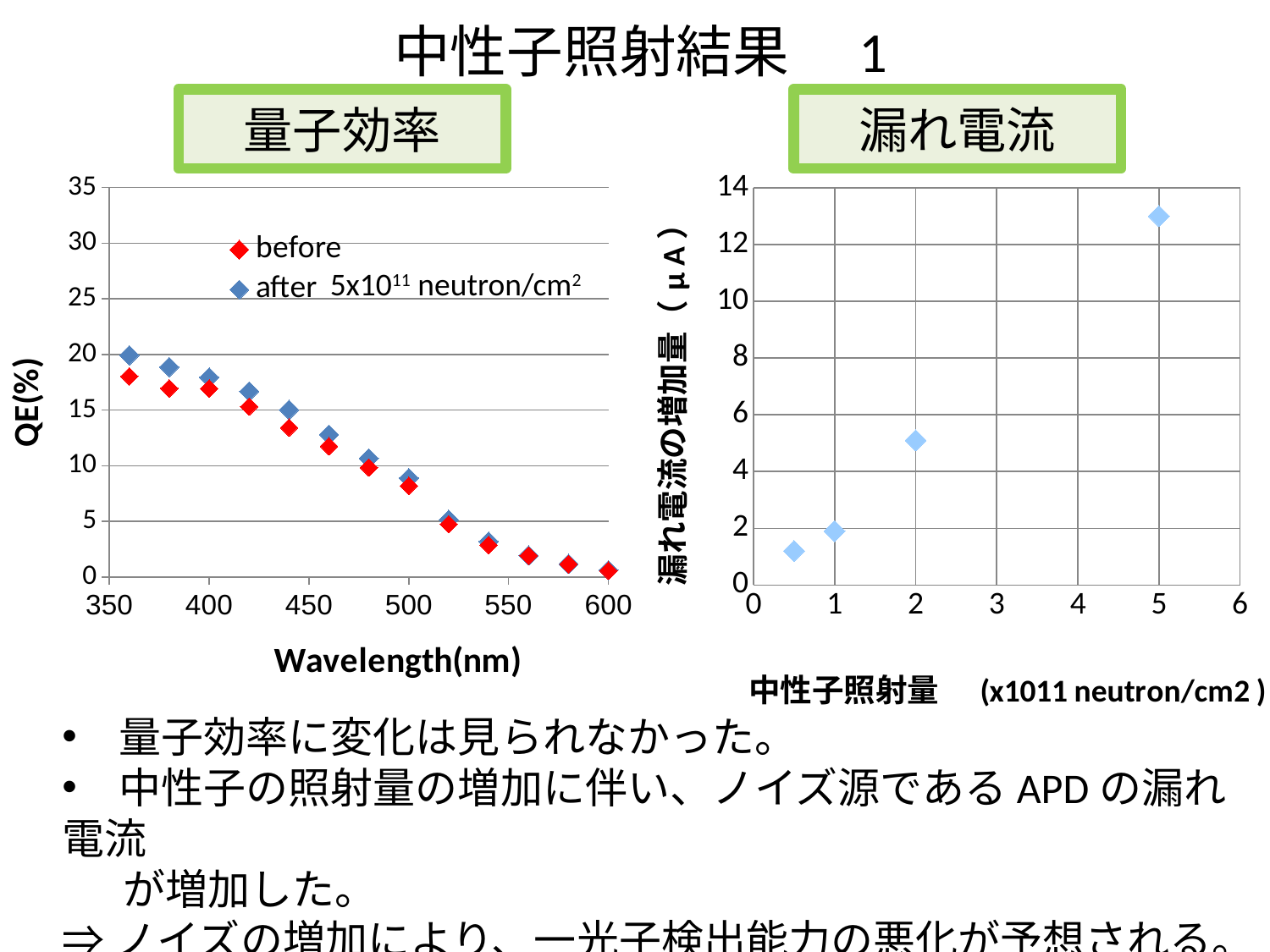
On the 量子効率 chart, is the 'after' value at 500 nm greater or less than 10? less On the 量子効率 chart, what are the two legend entries? before; after 5x10^11 neutron/cm2 On the 漏れ電流 chart, does the leakage current increase rise or fall as the neutron dose increases? rise On the 量子効率 chart, does QE rise or fall as wavelength increases from 350 to 600 nm? fall On the 量子効率 chart, is the 'before' value at 600 nm greater or less than 5? less On the 漏れ電流 chart, at which neutron dose is the leakage current increase highest? 5 On the 漏れ電流 chart, is the value at a dose of 5 greater or less than 12? greater On the 量子効率 chart, how many series does the legend list? 2 On the 漏れ電流 chart, how many data points are plotted? 4 What kind of chart is the 漏れ電流 chart on the right? scatter chart On the 量子効率 chart, what is the label of the x axis? Wavelength(nm)